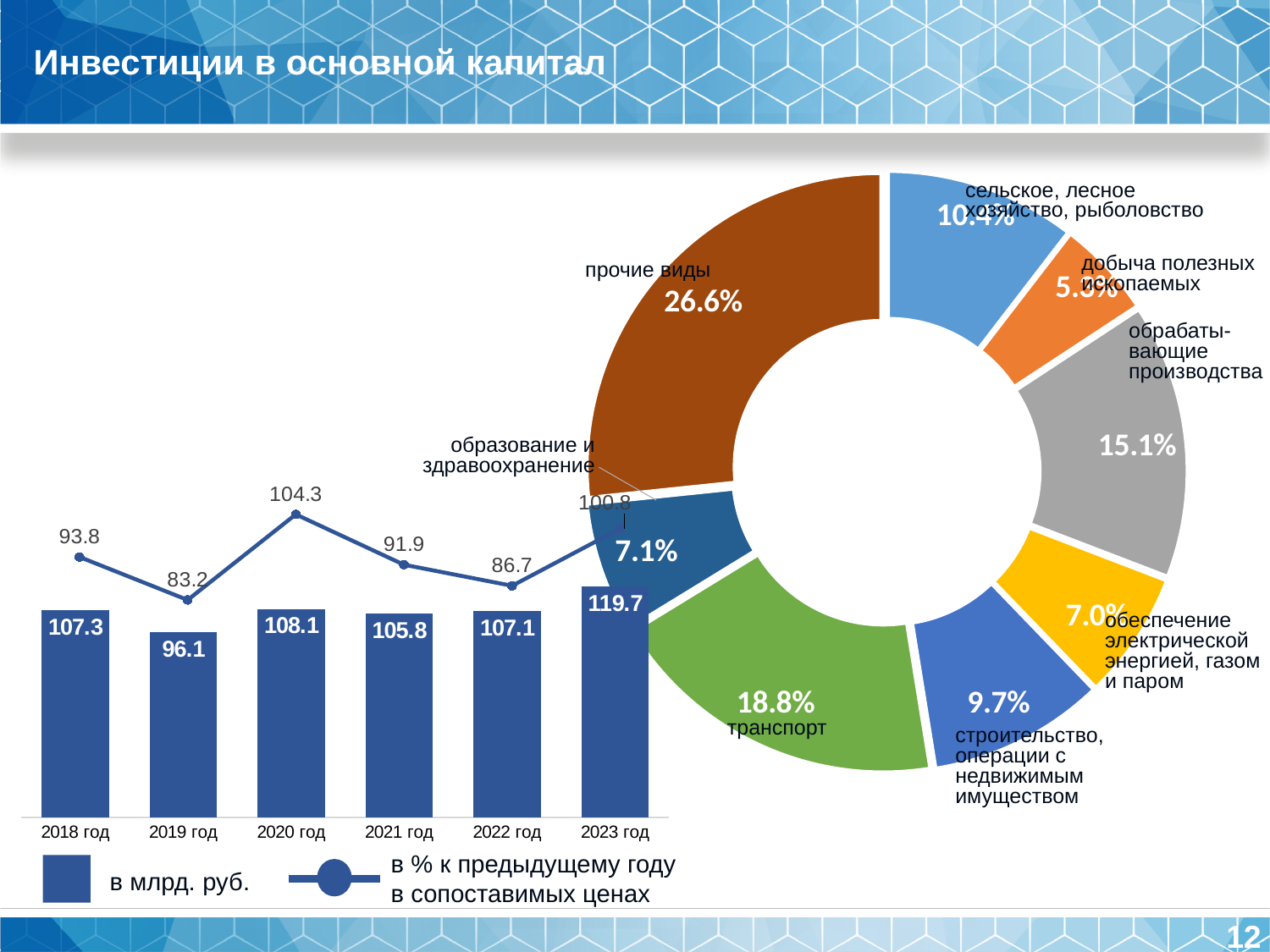
On the left chart, how many years are shown on the x axis? 6 On the right doughnut chart, what share does транспорт have? 18.8% On the left chart, which year has the lowest line value (% to previous year)? 2019 год On the left chart, what is the line value (% to previous year) for 2020 год? 104.3 What is the title of the slide? Инвестиции в основной капитал On the left chart, which year has the lowest bar value in billion rubles? 2019 год On the left chart, which year has the highest bar value in billion rubles? 2023 год On the left chart, what is the difference between the bar values for 2023 год and 2022 год? 12.6 On the left chart, what is the investment value in billion rubles for 2019 год? 96.1 On the left chart, what is the investment value in billion rubles for 2023 год? 119.7 On the right doughnut chart, which is larger: обрабатывающие производства or строительство, операции с недвижимым имуществом? обрабатывающие производства On the right doughnut chart, which sector has the largest share? прочие виды